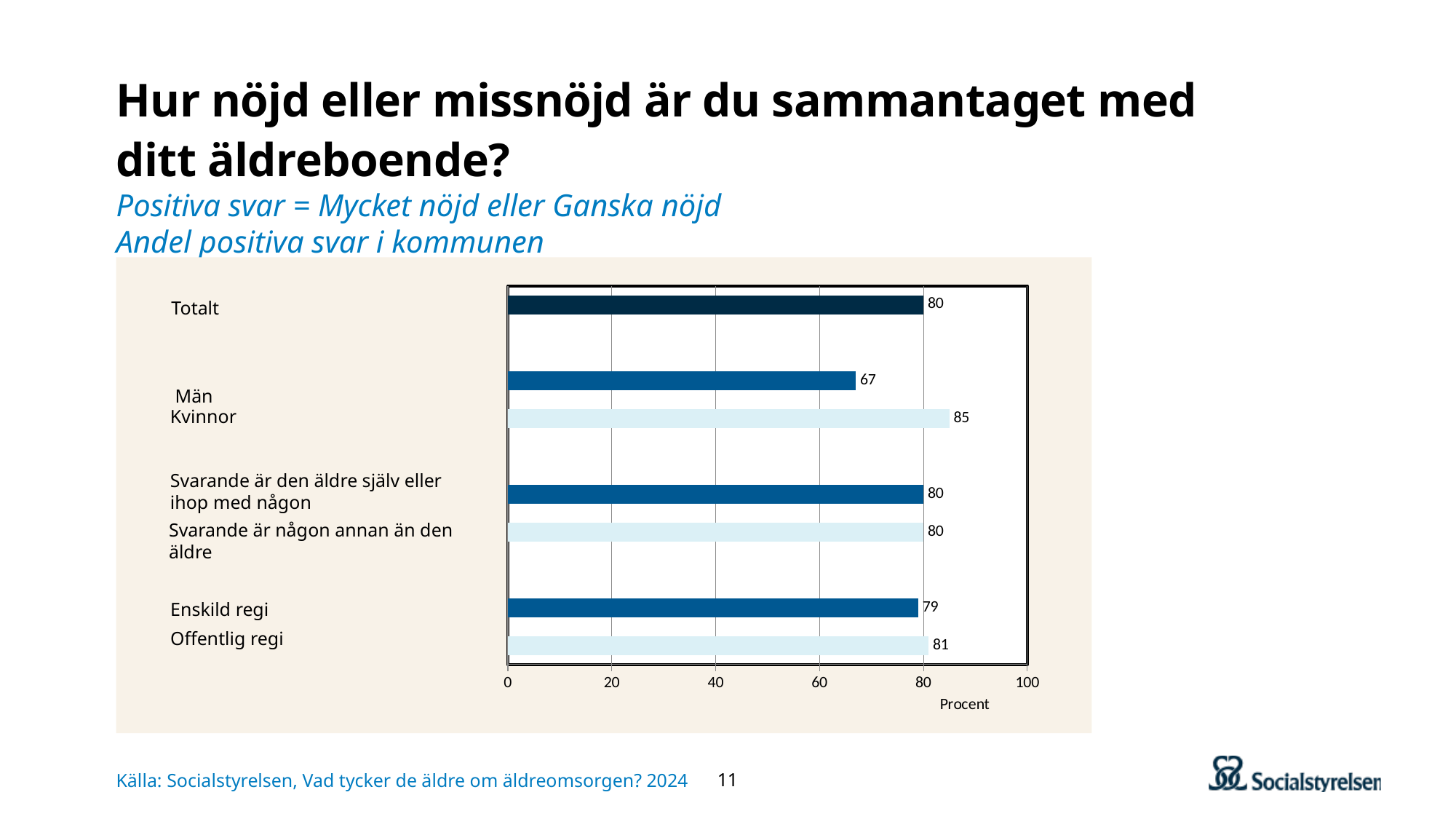
What is the difference between the values for Kvinnor and Män? 18 What is the value for Kvinnor? 85 Which is larger, the value for Offentlig regi or the value for Enskild regi? Offentlig regi What is the value for Offentlig regi? 81 Which category has the highest value? Kvinnor What kind of chart is shown on the slide? bar chart Is the value for Män greater or less than 80? less What is the value for Män? 67 What is the value for Enskild regi? 79 Which category has the lowest value? Män How many bars are plotted in the chart? 7 What is the value for Totalt? 80